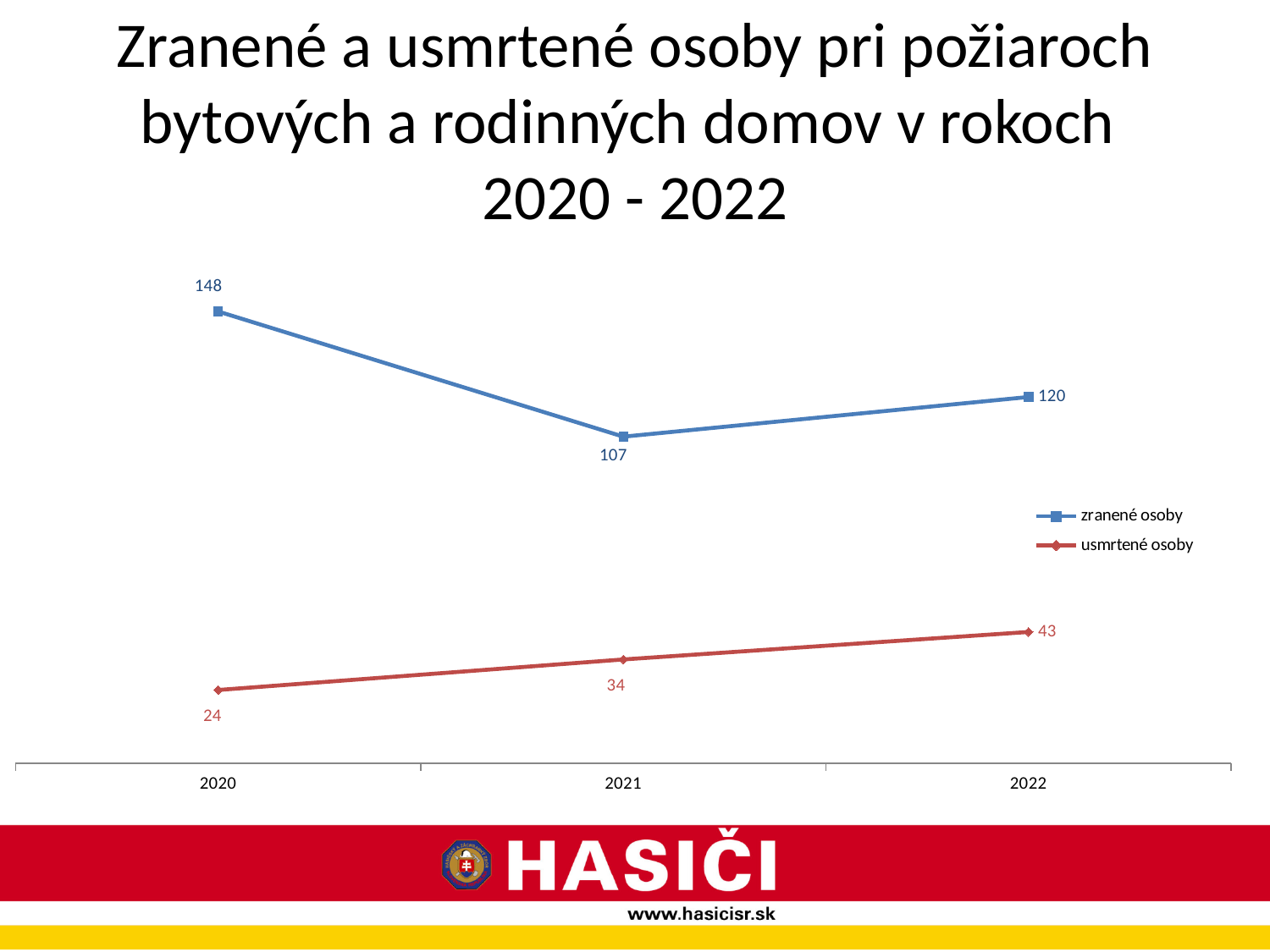
How many series does the legend list? 2 What is the value for zranené osoby in 2020? 148 What kind of chart is shown on the slide? line chart Does the value for usmrtené osoby rise or fall from 2020 to 2022? rise What is the difference between zranené osoby in 2020 and in 2022? 28 In which year is the value for usmrtené osoby highest? 2022 Which is larger: zranené osoby in 2022 or usmrtené osoby in 2022? zranené osoby in 2022 What is the value for usmrtené osoby in 2022? 43 How many years are shown on the x axis? 3 What is the difference between usmrtené osoby in 2022 and in 2020? 19 What is the value for zranené osoby in 2021? 107 In which year is the value for zranené osoby lowest? 2021